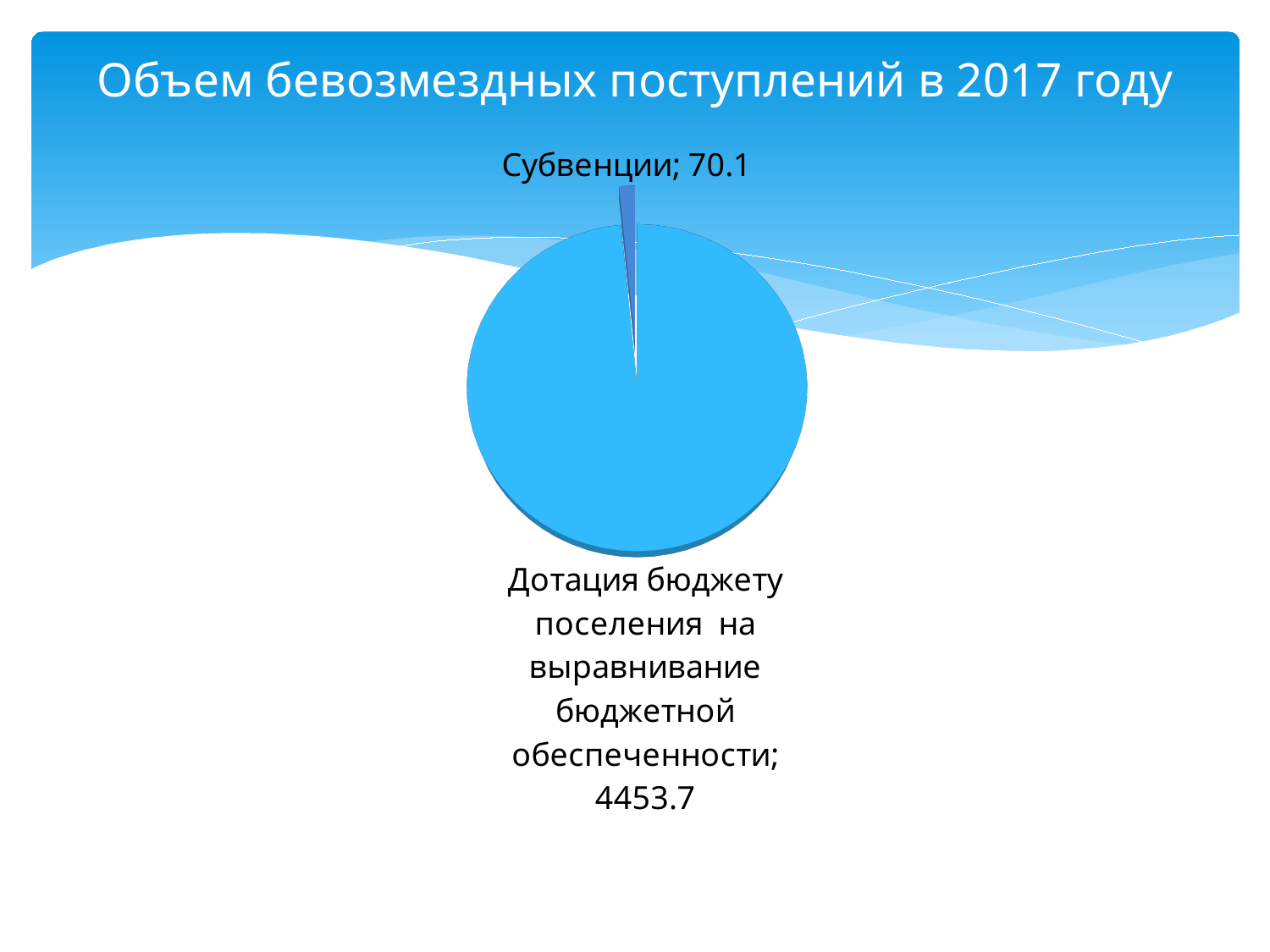
Which category has the largest slice of the pie? Дотация бюджету поселения на выравнивание бюджетной обеспеченности Which year does the chart title refer to? 2017 What is the difference between the value for Дотация бюджету поселения на выравнивание бюджетной обеспеченности and the value for Субвенции? 4383.6 How many slices does the pie chart have? 2 What type of chart is shown on the slide? pie chart What is the value for Субвенции? 70.1 What is the title of the chart? Объем бевозмездных поступлений в 2017 году Which is larger: the value for Субвенции or the value for Дотация бюджету поселения на выравнивание бюджетной обеспеченности? Дотация бюджету поселения на выравнивание бюджетной обеспеченности What is the value for Дотация бюджету поселения на выравнивание бюджетной обеспеченности? 4453.7 What is the total of all slices in the pie chart? 4523.8 Which category has the smallest slice of the pie? Субвенции